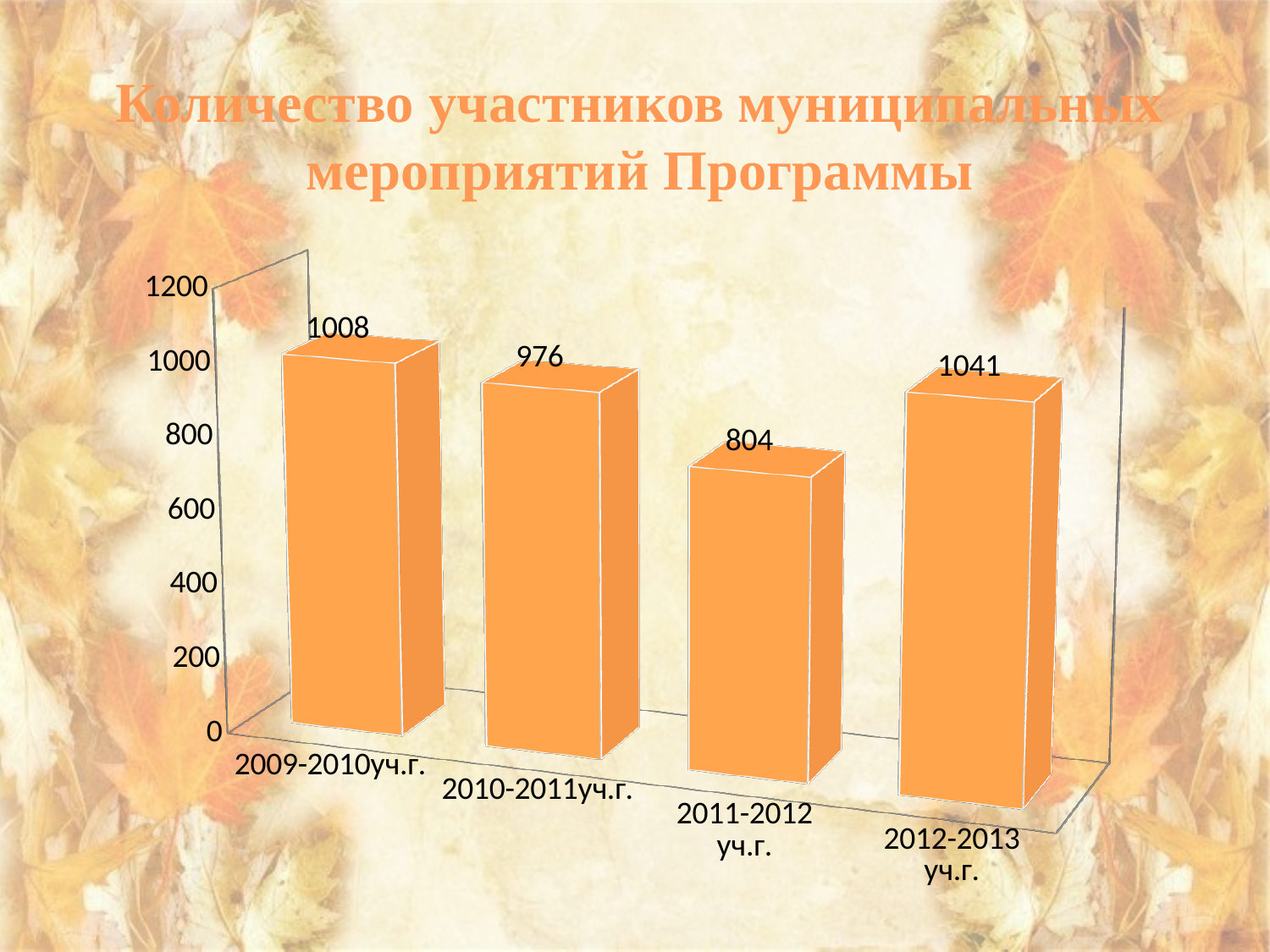
What is the value for 2009-2010уч.г.? 1008 How many academic years are shown on the chart? 4 What is the title of the chart? Количество участников муниципальных мероприятий Программы What kind of chart is shown on the slide? bar chart What is the value for 2012-2013 уч.г.? 1041 What is the value for 2010-2011уч.г.? 976 What is the difference between the values for 2009-2010уч.г. and 2010-2011уч.г.? 32 What is the value for 2011-2012 уч.г.? 804 Which academic year has the highest number of participants? 2012-2013 уч.г. Which academic year has the lowest number of participants? 2011-2012 уч.г. Which is larger, the value for 2009-2010уч.г. or the value for 2010-2011уч.г.? 2009-2010уч.г. What is the difference between the values for 2012-2013 уч.г. and 2011-2012 уч.г.? 237